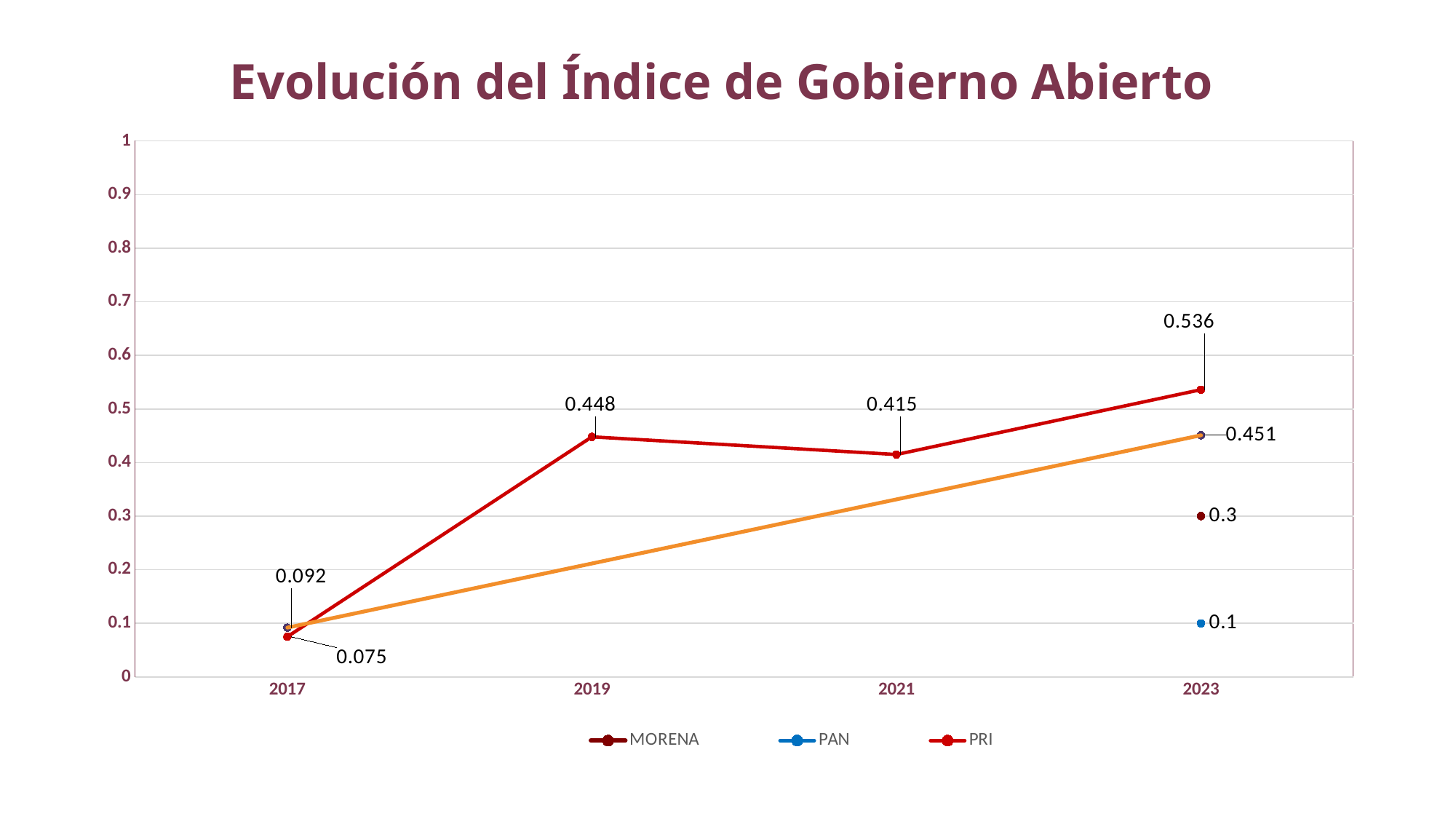
In which year does PRI reach its highest value? 2023 What is the value for PRI in 2019? 0.448 What is the value for PAN in 2023? 0.1 How many series does the legend list? 3 What is the value for MORENA in 2023? 0.3 What is the title of the chart? Evolución del Índice de Gobierno Abierto How many years are shown on the x axis? 4 What is the difference between the PRI values for 2023 and 2019? 0.088 What kind of chart is shown on the slide? line chart What is the value for PRI in 2023? 0.536 Does the PRI value rise or fall from 2019 to 2021? fall What is the value for PRI in 2021? 0.415